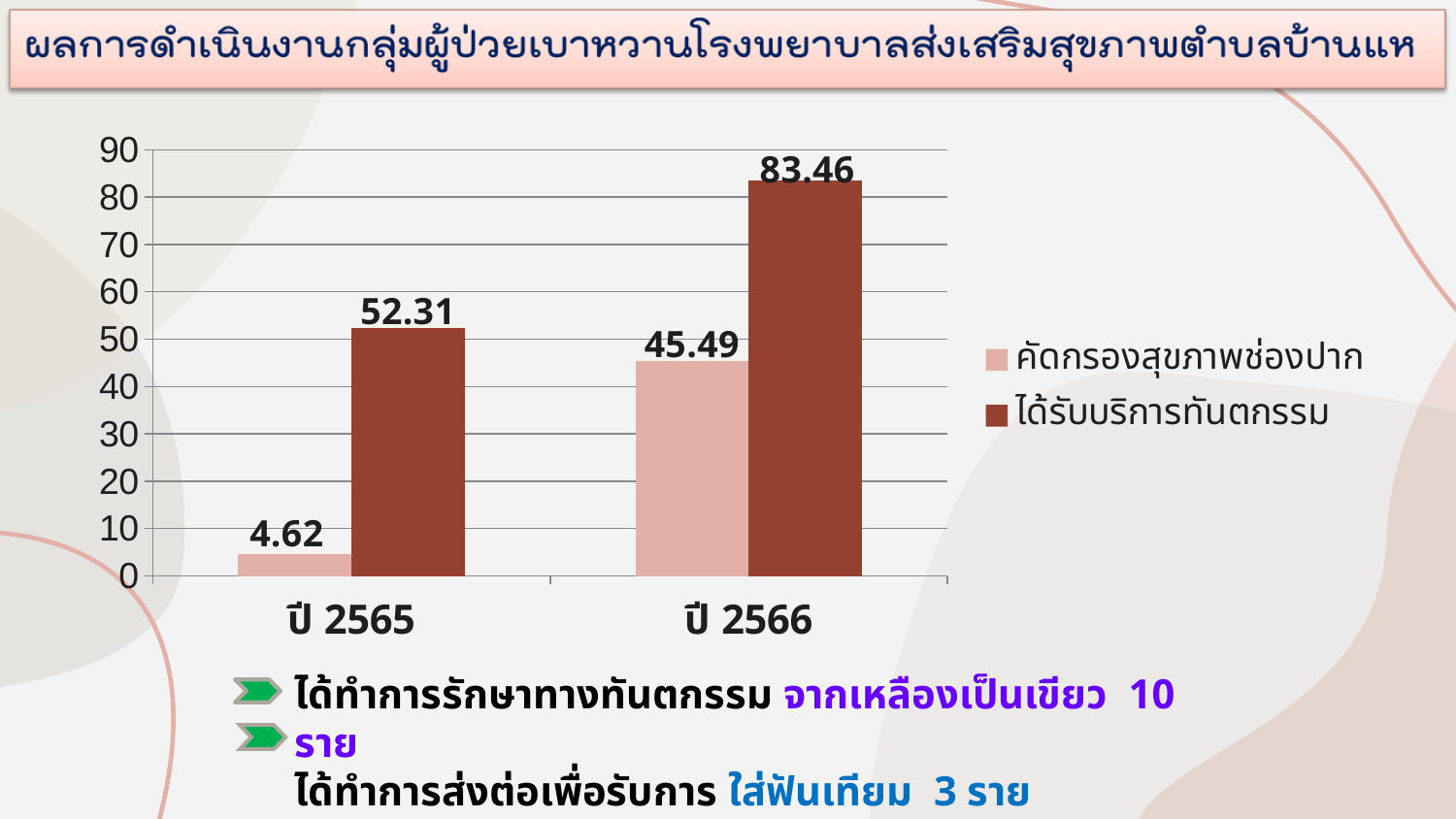
What is the difference between the ได้รับบริการทันตกรรม values for ปี 2566 and ปี 2565? 31.15 How many series does the legend list? 2 What is the value for ได้รับบริการทันตกรรม in ปี 2565? 52.31 Does the value for คัดกรองสุขภาพช่องปาก rise or fall from ปี 2565 to ปี 2566? Rise What kind of chart is shown on the slide? Bar chart Which is larger in ปี 2566: คัดกรองสุขภาพช่องปาก or ได้รับบริการทันตกรรม? ได้รับบริการทันตกรรม What is the value for คัดกรองสุขภาพช่องปาก in ปี 2566? 45.49 What is the difference between the คัดกรองสุขภาพช่องปาก values for ปี 2566 and ปี 2565? 40.87 What is the value for ได้รับบริการทันตกรรม in ปี 2566? 83.46 Which year has the highest value for ได้รับบริการทันตกรรม? ปี 2566 Which year has the lowest value for คัดกรองสุขภาพช่องปาก? ปี 2565 What is the value for คัดกรองสุขภาพช่องปาก in ปี 2565? 4.62